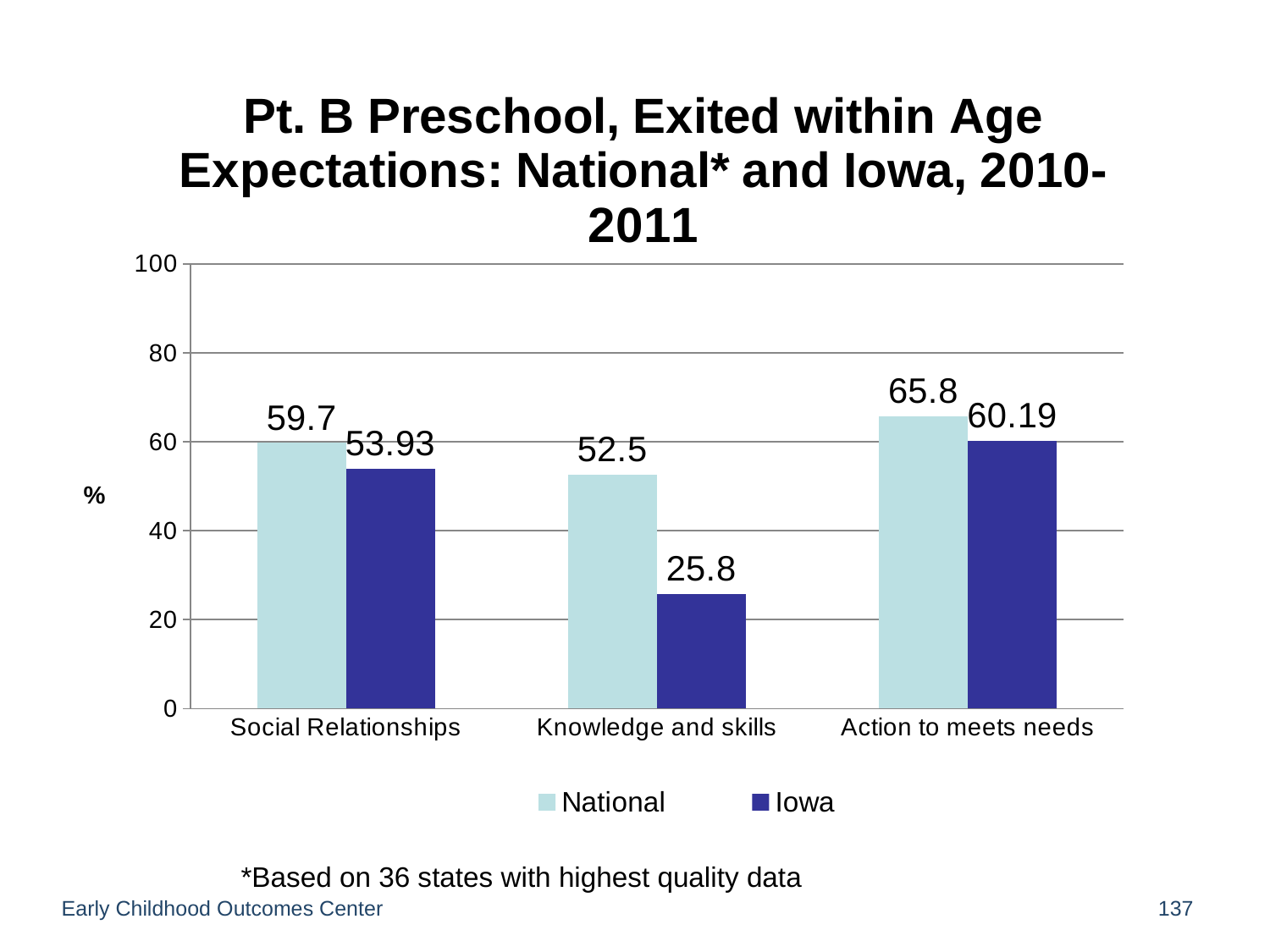
What is the difference between the National and Iowa values for Knowledge and skills? 26.7 What kind of chart is shown on the slide? bar chart What does the footnote say the National figures are based on? 36 states with highest quality data How many series does the legend list? 2 What is the Iowa value for Action to meets needs? 60.19 Which category has the lowest Iowa value? Knowledge and skills What is the Iowa value for Knowledge and skills? 25.8 What is the National value for Social Relationships? 59.7 Is the Iowa value for Knowledge and skills greater or less than 40? less Which is larger for Social Relationships, the National value or the Iowa value? National How many categories are shown on the x axis? 3 Which category has the highest National value? Action to meets needs